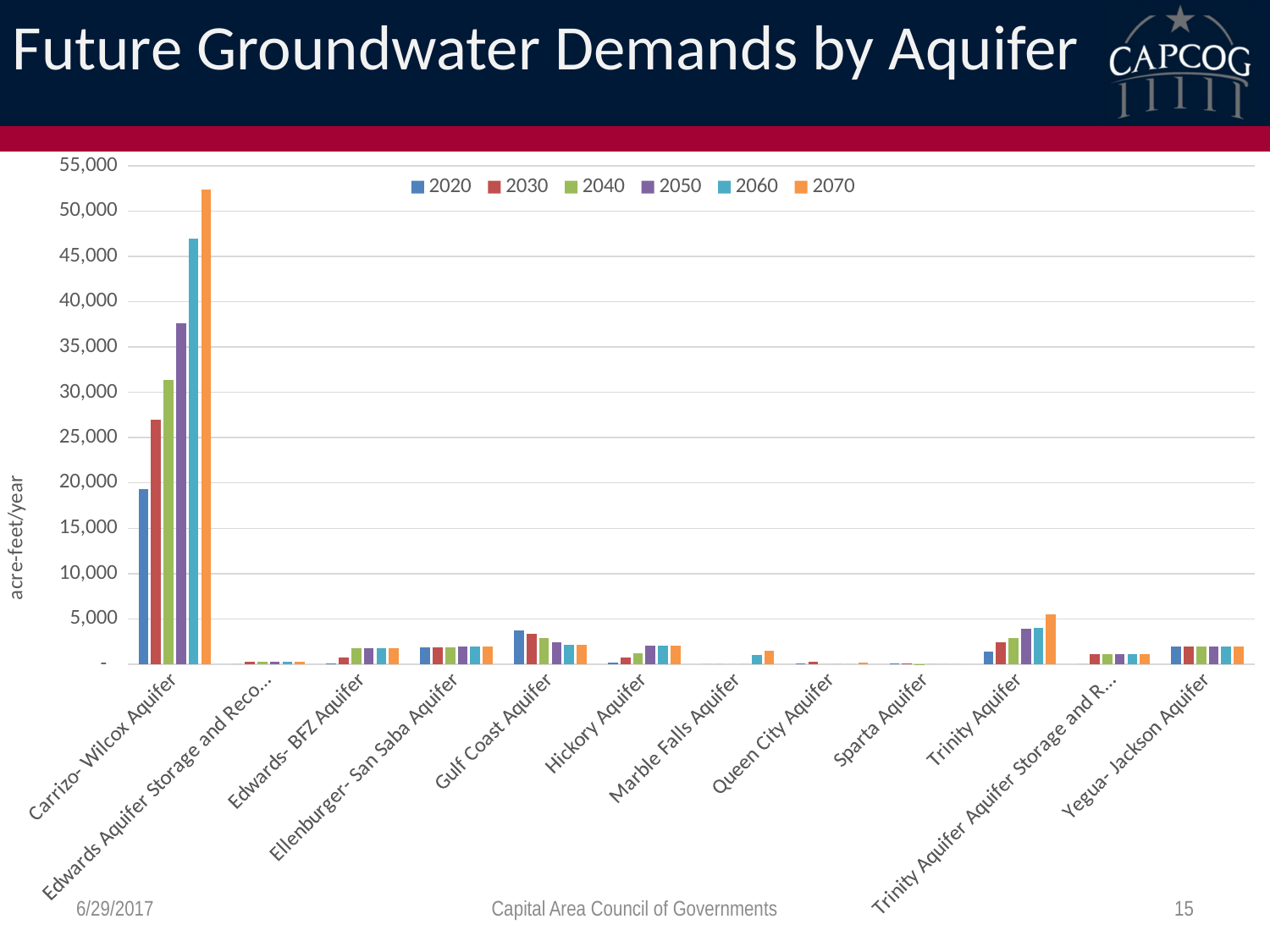
What is the title of the slide? Future Groundwater Demands by Aquifer What kind of chart is shown on the slide? bar chart Do the values for the Carrizo- Wilcox Aquifer rise or fall from 2020 to 2070? rise Is the 2070 value for the Carrizo- Wilcox Aquifer greater or less than 50,000? greater How many aquifer categories are shown on the x axis? 12 Is the 2060 value for the Carrizo- Wilcox Aquifer greater or less than 45,000? greater How many series does the legend list? 6 Which is larger, the 2070 value for the Trinity Aquifer or the 2070 value for the Gulf Coast Aquifer? Trinity Aquifer What is the label on the y axis? acre-feet/year Is the 2020 value for the Carrizo- Wilcox Aquifer greater or less than 20,000? less Which aquifer has the highest groundwater demand in 2070? Carrizo- Wilcox Aquifer